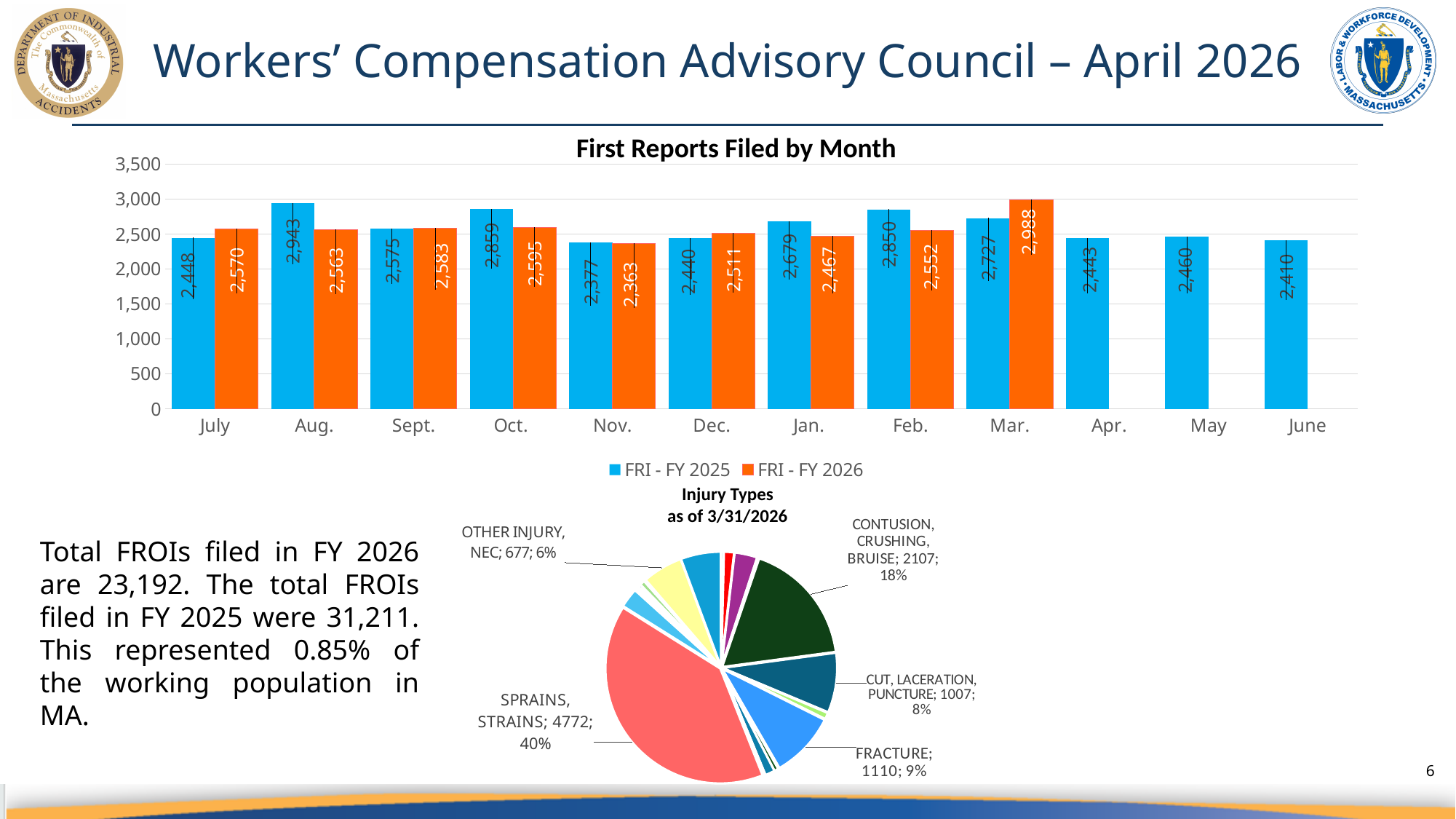
In the 'Injury Types as of 3/31/2026' pie chart, what is the value for CONTUSION, CRUSHING, BRUISE? 2107 In the 'Injury Types as of 3/31/2026' pie chart, what share of the pie is SPRAINS, STRAINS? 40% In the 'First Reports Filed by Month' chart, what is the FRI - FY 2025 value for August? 2,943 In the 'First Reports Filed by Month' chart, what is the FRI - FY 2026 value for March? 2,988 In the 'First Reports Filed by Month' chart, what is the difference between the FRI - FY 2025 and FRI - FY 2026 values for October? 264 In the 'Injury Types as of 3/31/2026' pie chart, which is larger: FRACTURE or CUT, LACERATION, PUNCTURE? FRACTURE In the 'First Reports Filed by Month' chart, how many series does the legend list? 2 In the 'First Reports Filed by Month' chart, which month has the lowest FRI - FY 2025 value? Nov. In the 'First Reports Filed by Month' chart, which month has the highest FRI - FY 2026 value? Mar. In the 'First Reports Filed by Month' chart, how many months are shown on the x axis? 12 In the 'First Reports Filed by Month' chart, which is larger for December: FRI - FY 2025 or FRI - FY 2026? FRI - FY 2026 What kind of chart is 'First Reports Filed by Month'? Bar chart